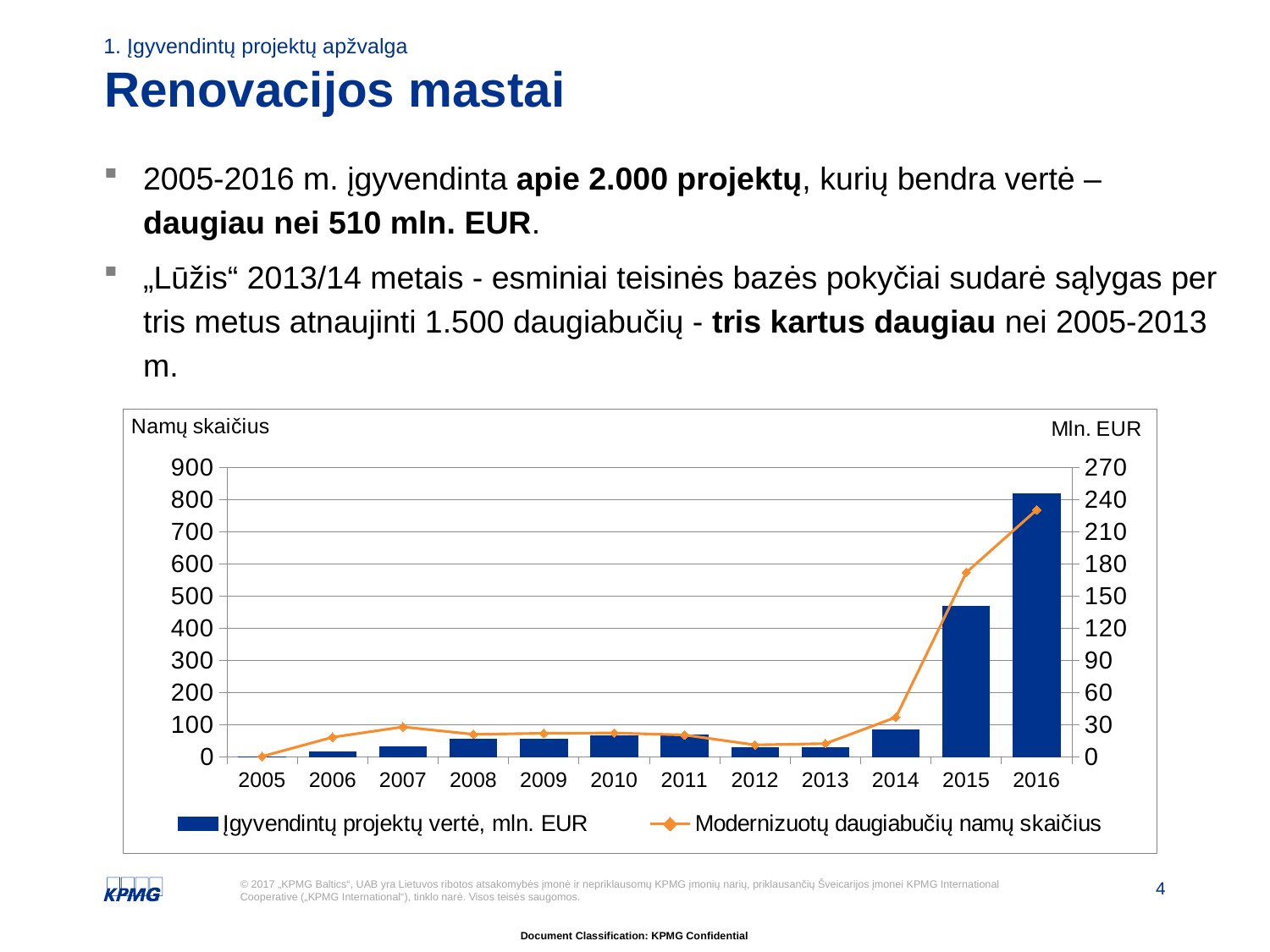
How many years are shown on the x axis of the chart? 12 In which year does the line 'Modernizuotų daugiabučių namų skaičius' reach its highest point? 2016 Is the value of 'Modernizuotų daugiabučių namų skaičius' in 2015 greater or less than 500 on the left axis? greater In which year is the bar for 'Įgyvendintų projektų vertė, mln. EUR' the lowest? 2005 What kind of chart is shown on the slide? A combined bar and line chart Does the line 'Modernizuotų daugiabučių namų skaičius' rise or fall from 2013 to 2016? rise How many series does the chart legend list? 2 In which year is the bar for 'Įgyvendintų projektų vertė, mln. EUR' the highest? 2016 Is the value of 'Modernizuotų daugiabučių namų skaičius' in 2014 greater or less than 200 on the left axis? less Is the bar for 'Įgyvendintų projektų vertė, mln. EUR' in 2016 greater or less than 210 on the right axis? greater Which year has the larger bar for 'Įgyvendintų projektų vertė, mln. EUR', 2015 or 2016? 2016 What is the label of the right-hand vertical axis of the chart? Mln. EUR